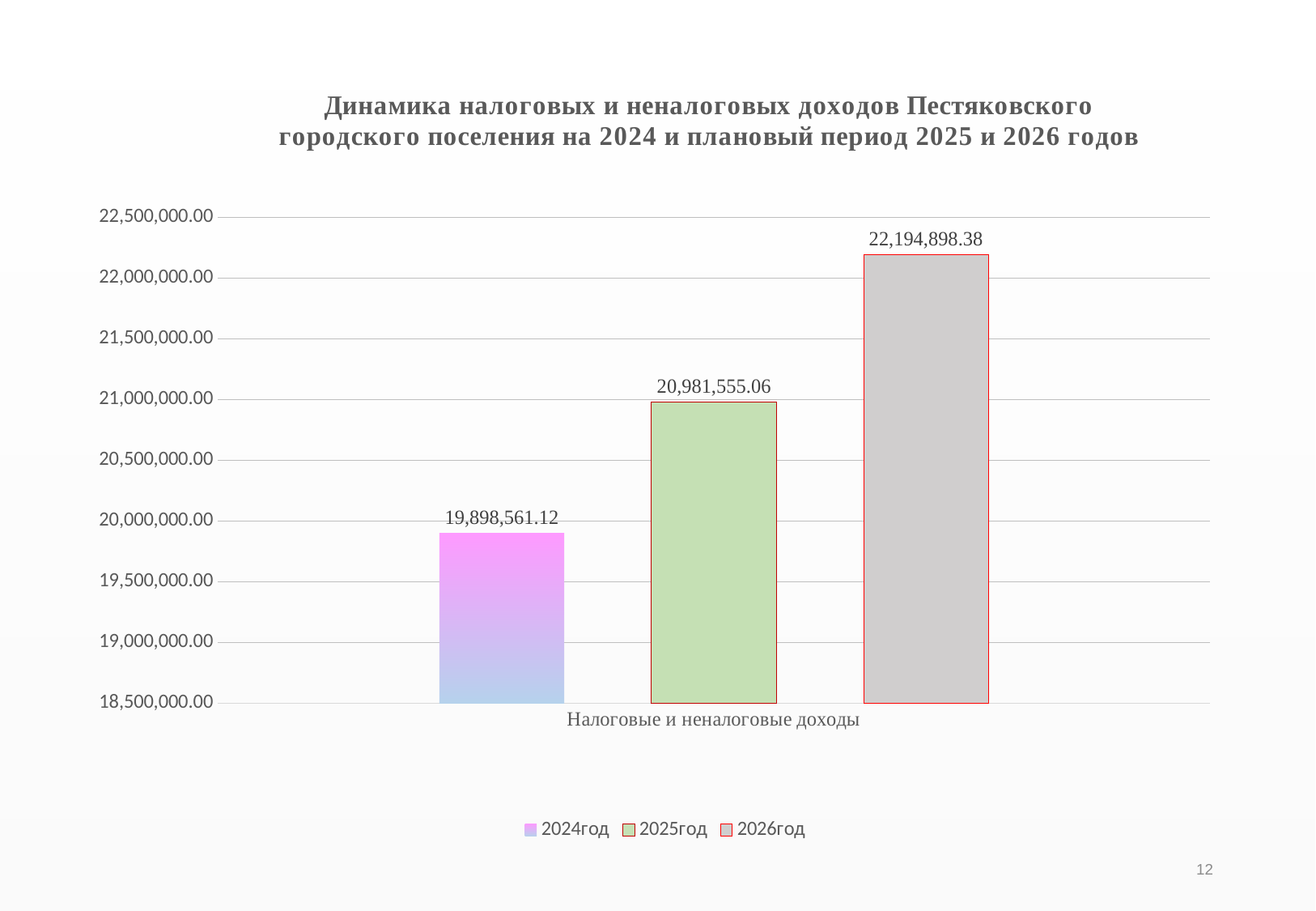
Is the value for 2025год greater or less than 21,000,000.00? less What is the difference between the values for 2025год and 2024год? 1,082,993.94 What is the value for 2026год? 22,194,898.38 What kind of chart is shown on the slide? bar chart How many series does the legend list? 3 Which year has the highest value? 2026год What is the value for 2024год? 19,898,561.12 What is the difference between the values for 2026год and 2024год? 2,296,337.26 What is the value for 2025год? 20,981,555.06 Which is larger, the value for 2025год or the value for 2026год? 2026год Which year has the lowest value? 2024год What is the category label shown on the x axis? Налоговые и неналоговые доходы